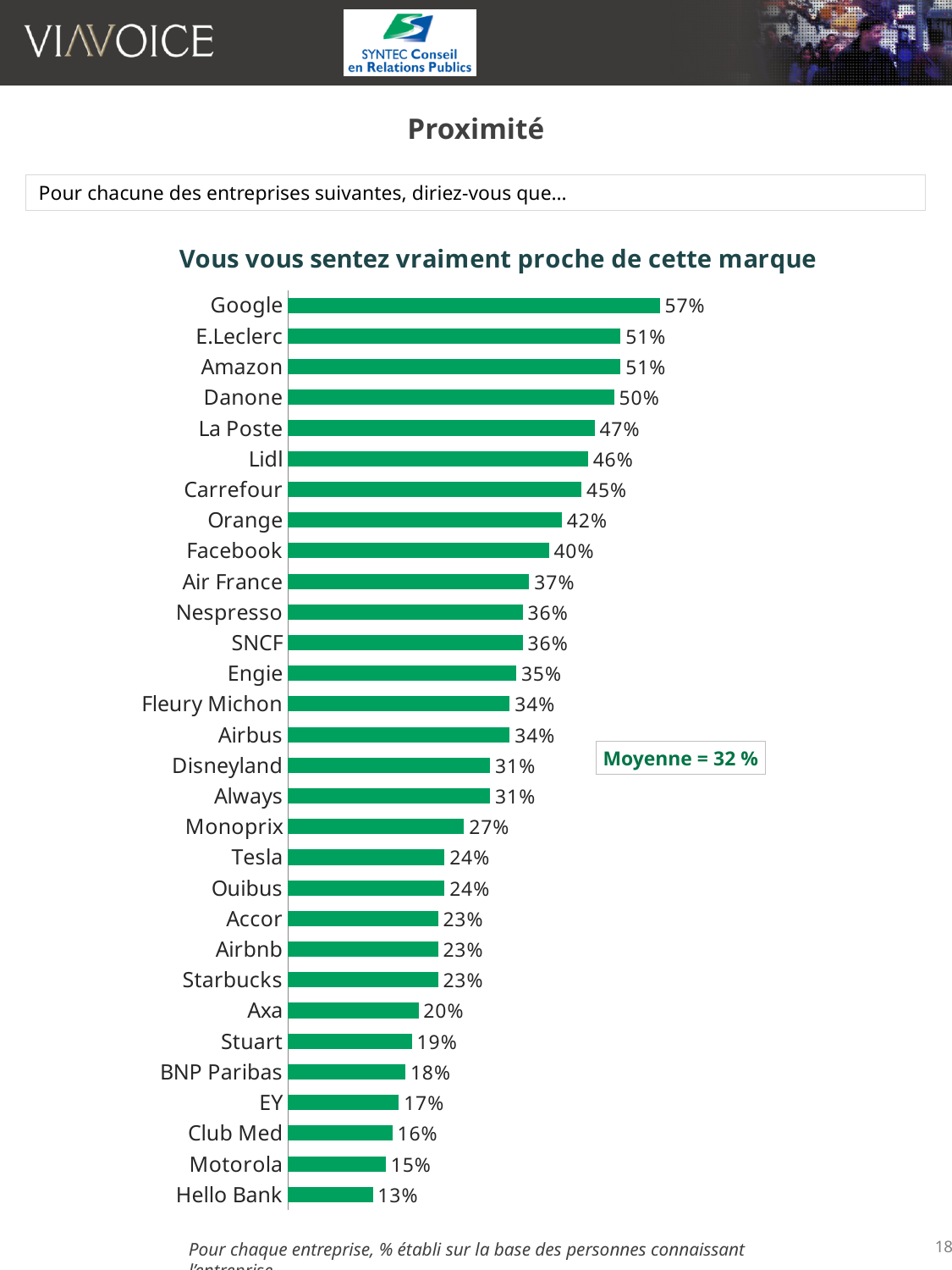
Which company has the highest value? Google What is the difference between the values for Tesla and Motorola? 9% How many companies are shown in the chart? 30 What is the difference between the values for Google and Danone? 7% What is the title of the chart? Vous vous sentez vraiment proche de cette marque What kind of chart is shown on the slide? Bar chart What average (Moyenne) value is indicated on the chart? 32 % What is the value for Carrefour? 45% What is the value for Hello Bank? 13% Which company has the lowest value? Hello Bank Which has a larger value, Orange or Facebook? Orange What is the value for Google? 57%